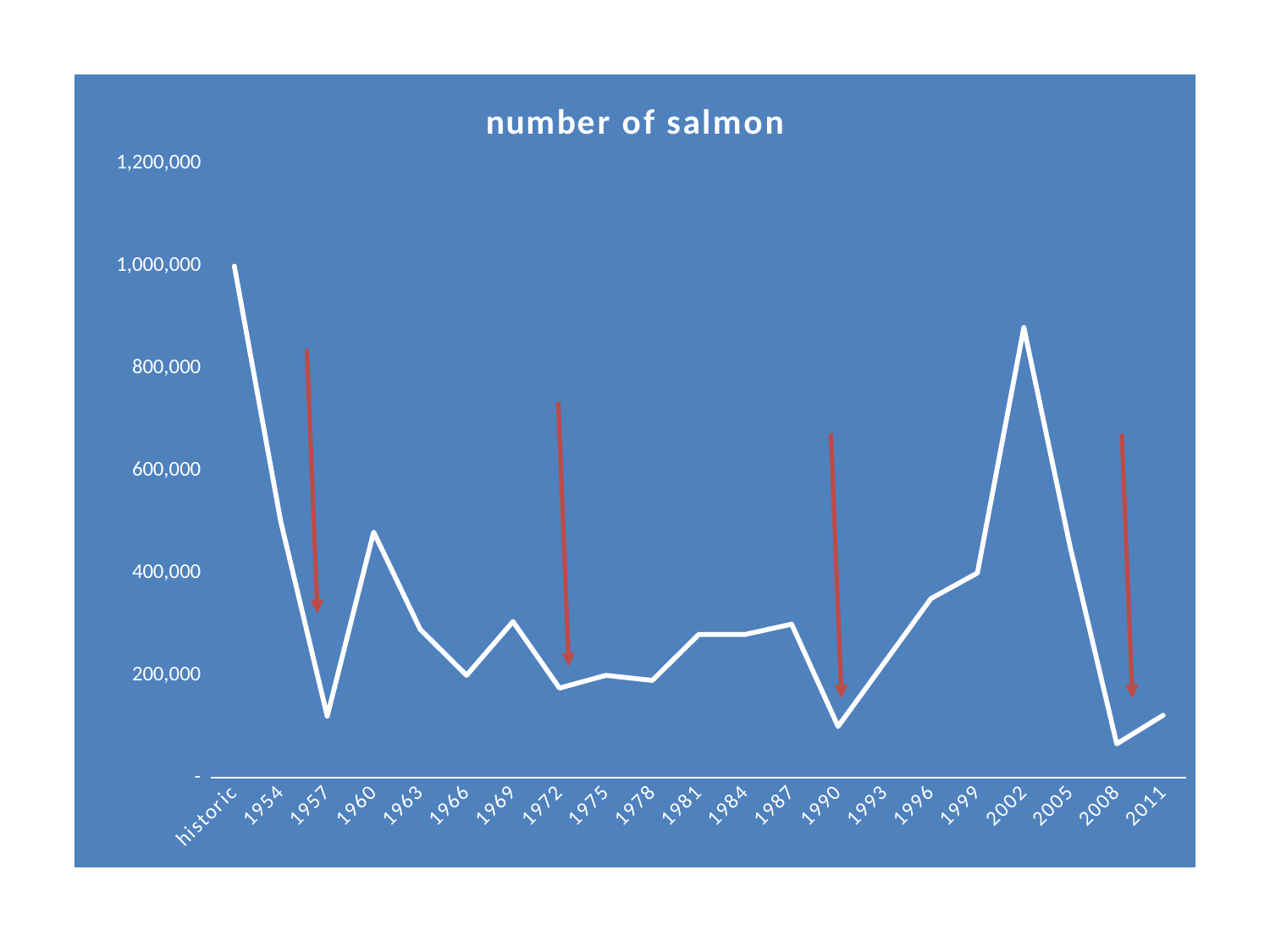
How many red arrows are drawn on the chart? 4 Does the number of salmon rise or fall between 1990 and 2002? rise Is the value for 1960 greater or less than 400,000? greater Which x-axis category has the highest number of salmon? historic Is the value for 2002 greater or less than 800,000? greater What is the title of the chart? number of salmon Is the value for 1957 greater or less than 200,000? less Which is larger, the value for 1960 or the value for 1963? 1960 What kind of chart is shown on the slide? line chart